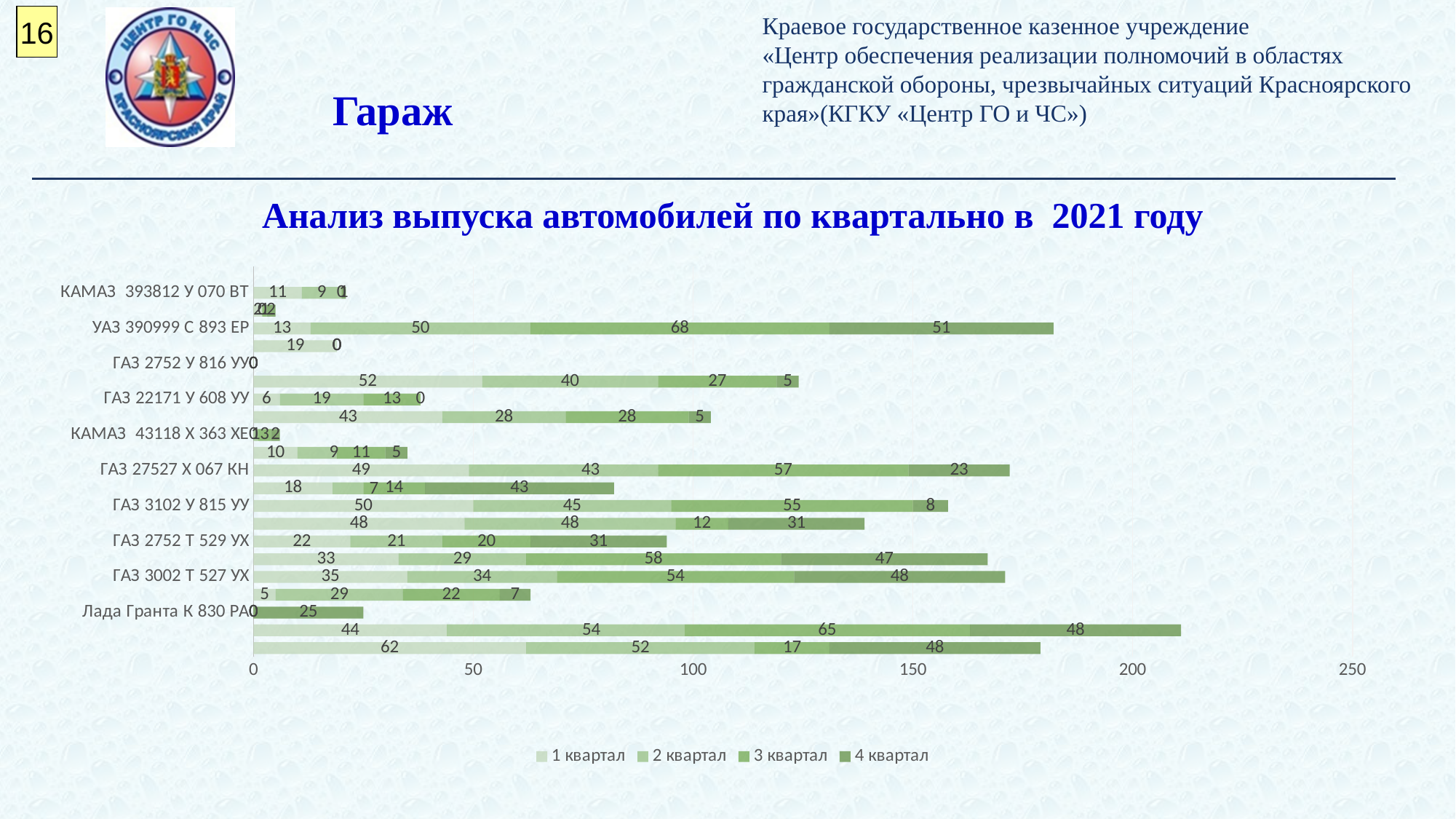
What is the value for 4 квартал for ГАЗ 3102 У 815 УУ? 8 What is the value for 3 квартал for УАЗ 390999 С 893 ЕР? 68 What kind of chart is shown on the slide? bar chart Is the total of the stacked bar for ГАЗ 27527 Х 067 КН greater or less than 150? greater What is the total of the stacked bar for УАЗ 390999 С 893 ЕР? 182 What is the value for 1 квартал for ГАЗ 27527 Х 067 КН? 49 What is the value for 2 квартал for ГАЗ 3002 Т 527 УХ? 34 What is the difference between the 3 квартал and 4 квартал values for УАЗ 390999 С 893 ЕР? 17 What is the title of the chart? Анализ выпуска автомобилей по квартально в 2021 году What is the total of the stacked bar for ГАЗ 2752 Т 529 УХ? 94 How many series does the legend list? 4 For ГАЗ 3102 У 815 УУ, which is larger: the 1 квартал value or the 2 квартал value? 1 квартал